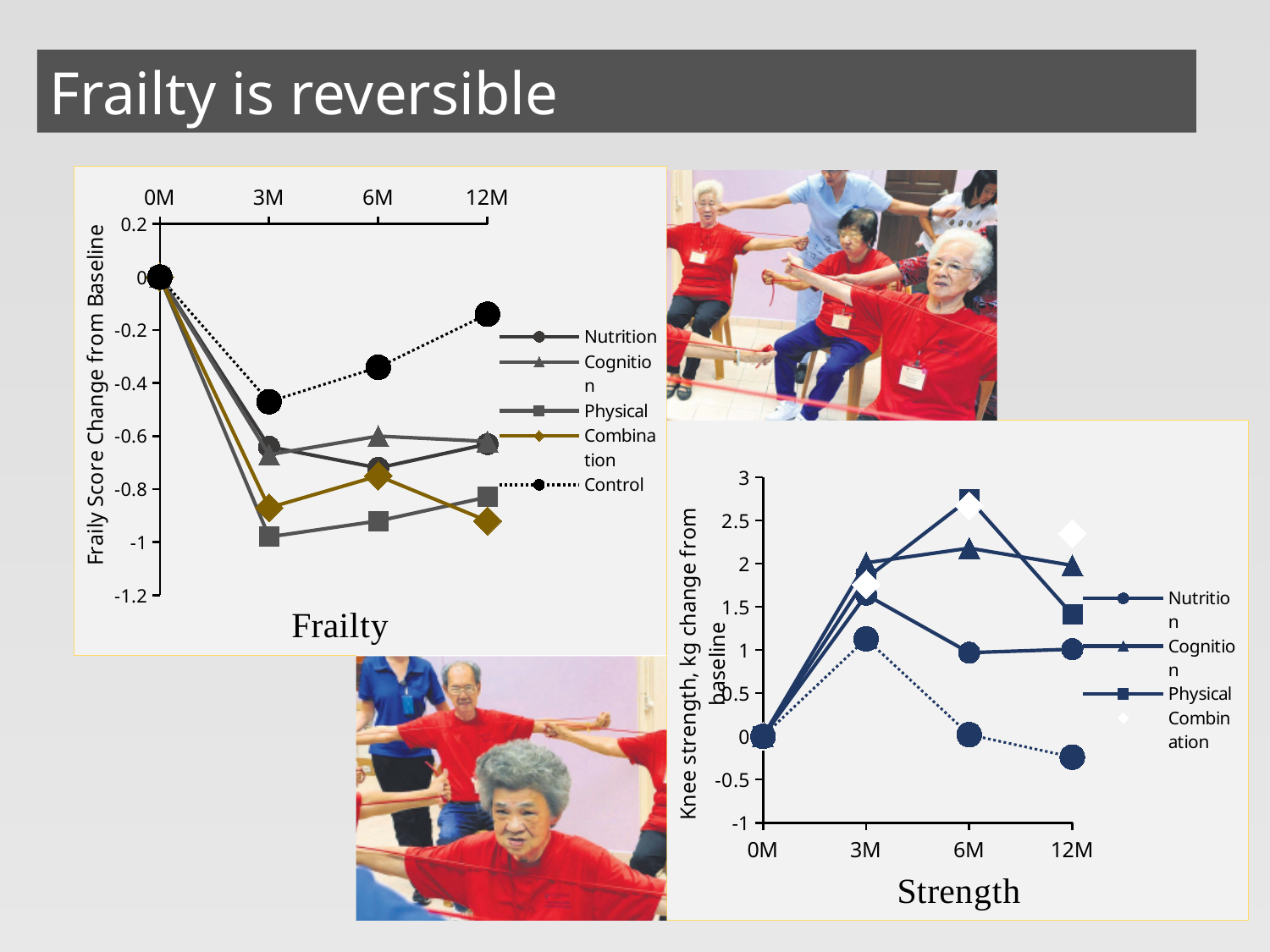
In the Strength chart, is the value for Nutrition at 12M greater or less than 0? greater How many time points are plotted on the x axis of the Strength chart? 4 In the Frailty chart, which series has the lowest value at 3M? Physical In the Frailty chart, is the value for Control at 12M greater or less than -0.2? greater In the Frailty chart, what is the value of the Control series at 0M? 0 In the Frailty chart, is the value for Physical at 3M greater or less than -0.8? less In the Strength chart, which series has the highest value at 6M? Physical What type of chart is the Frailty chart? line chart How many series does the legend of the Frailty chart list? 5 In the Frailty chart, which series has the highest value at 12M? Control How many series does the legend of the Strength chart list? 4 In the Frailty chart, which is larger at 6M, Control or Physical? Control